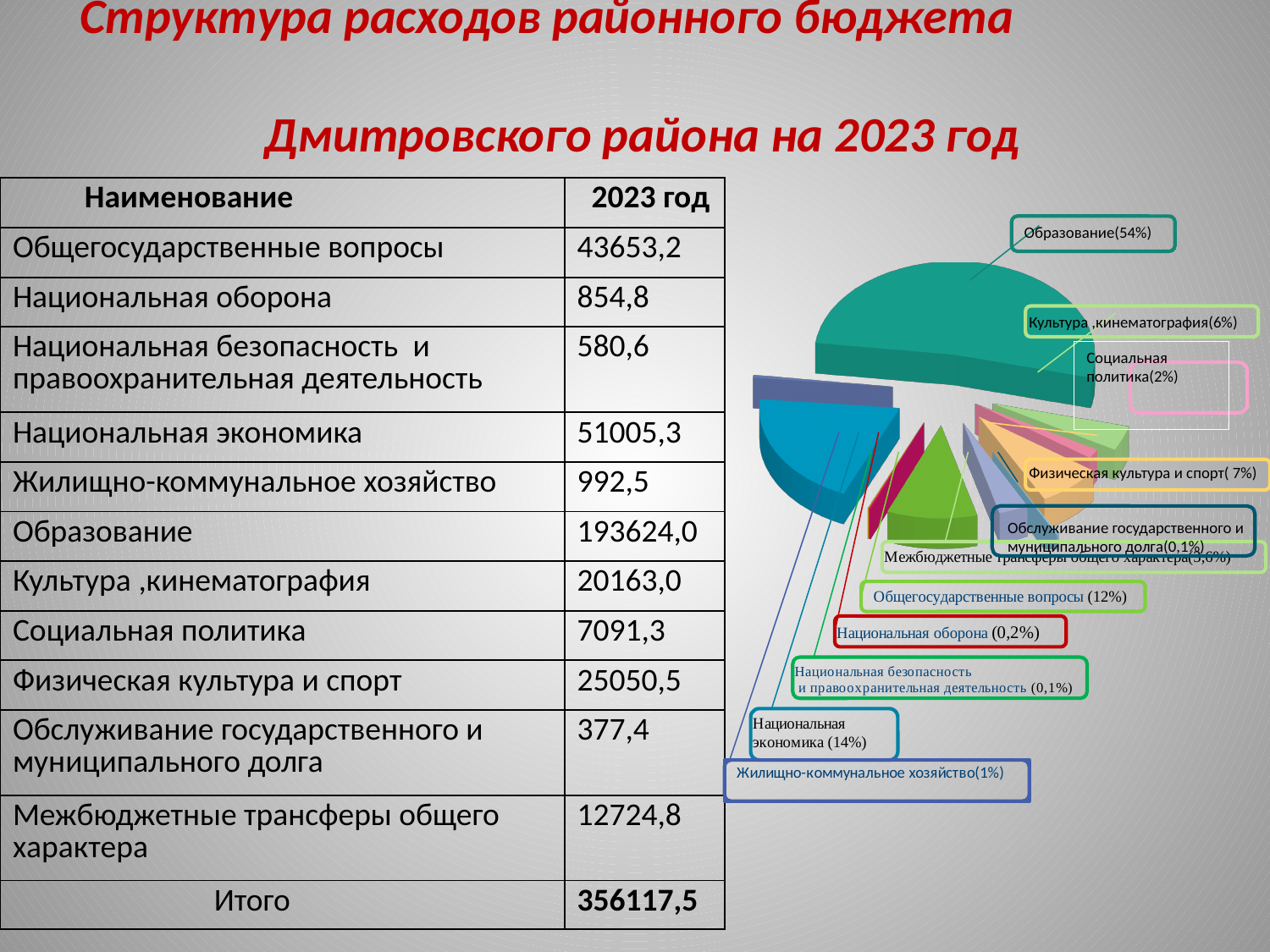
Which category has the largest slice of the pie? Образование What kind of chart is shown on the slide? pie chart What share of the pie does Образование have? 54% What share of the pie does Физическая культура и спорт have? 7% What share of the pie does Жилищно-коммунальное хозяйство have? 1% Which slice is larger: Национальная экономика or Общегосударственные вопросы? Национальная экономика How many slices does the pie chart have? 11